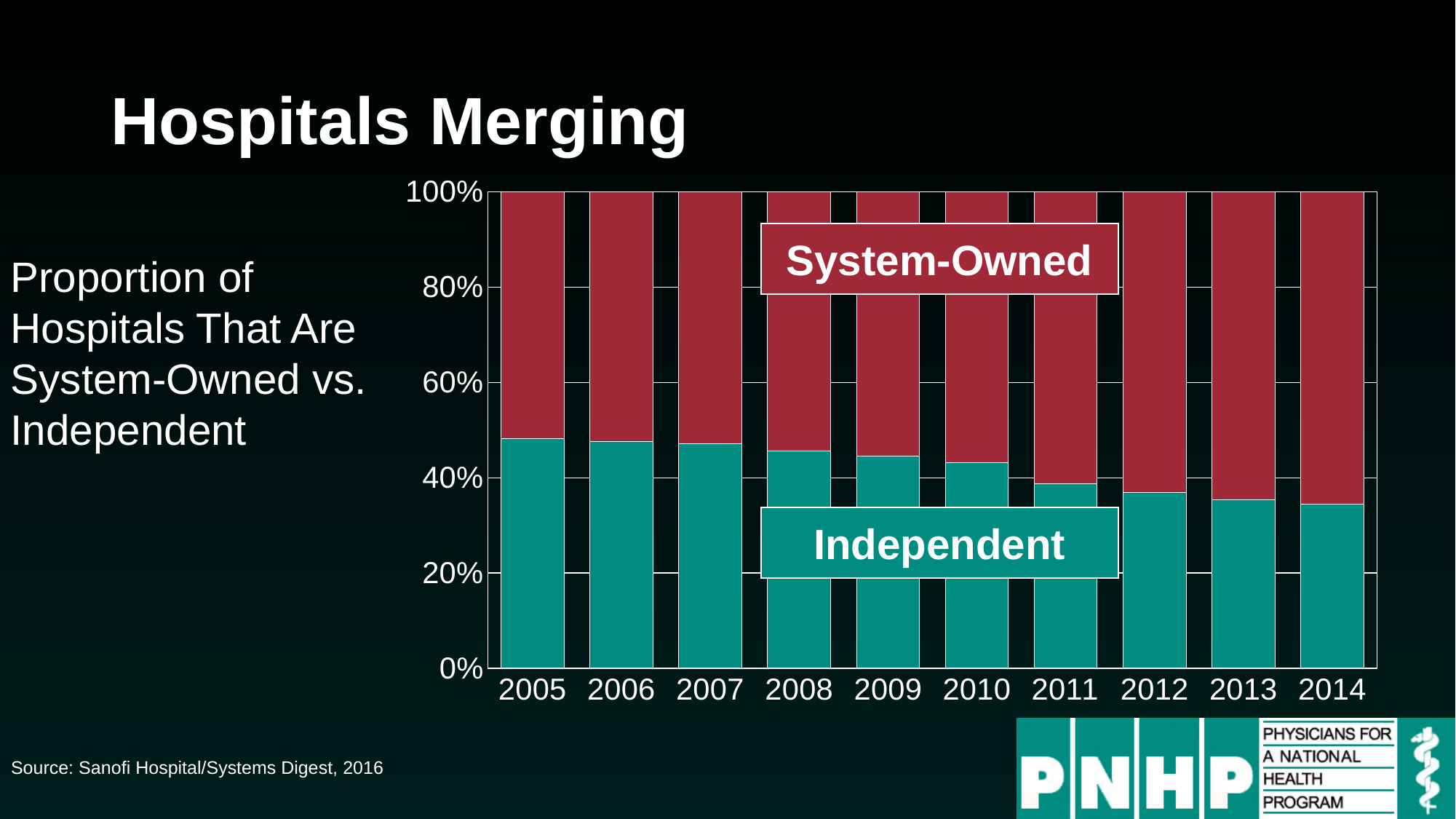
Which two series are labelled on the chart? System-Owned and Independent Is the Independent share in 2008 greater or less than 40%? greater How many series does the chart show? 2 Which year has the larger Independent share, 2005 or 2014? 2005 What is the total of each stacked bar in the chart? 100% Does the System-Owned share rise or fall from 2005 to 2014? Rise What is the title of the slide containing the chart? Hospitals Merging Does the Independent share rise or fall from 2005 to 2014? Fall How many years are shown along the x axis of the chart? 10 What kind of chart is shown on the slide? Stacked bar chart Is the System-Owned share in 2014 greater or less than 60%? greater Is the Independent share in 2014 greater or less than 40%? less